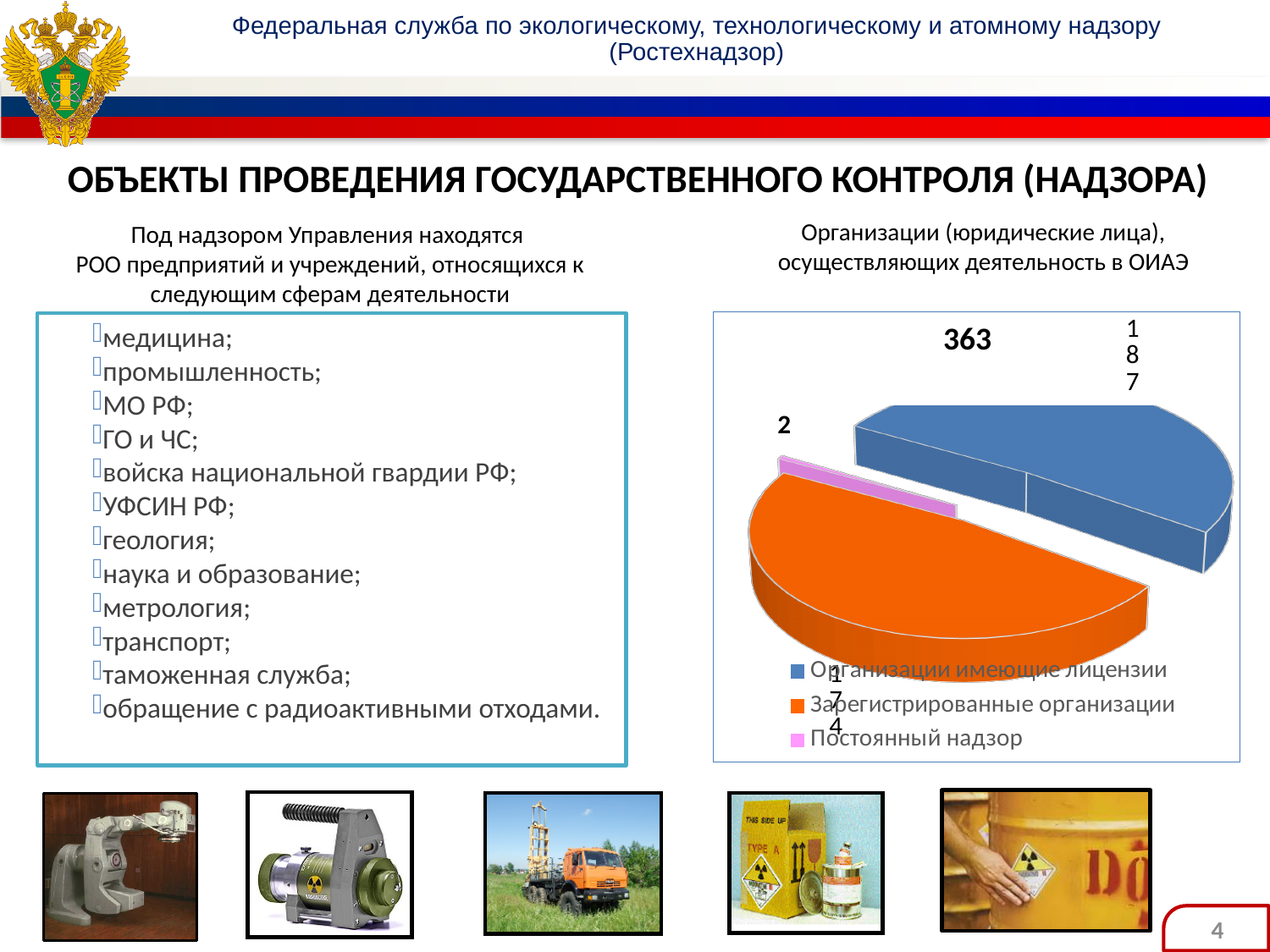
What total number is printed above the pie chart? 363 What is the value for Организации имеющие лицензии in the pie chart? 187 Which category has the largest slice in the pie chart? Организации имеющие лицензии What colour is the Постоянный надзор slice in the pie chart? pink What is the difference between the values for Организации имеющие лицензии and Зарегистрированные организации? 13 What kind of chart is shown on the right side of the slide? pie chart Which is larger in the pie chart: Постоянный надзор or Зарегистрированные организации? Зарегистрированные организации What is the value for Зарегистрированные организации in the pie chart? 174 Which category has the smallest slice in the pie chart? Постоянный надзор How many entries does the legend of the pie chart list? 3 How many slices does the pie chart have? 3 What is the value for Постоянный надзор in the pie chart? 2